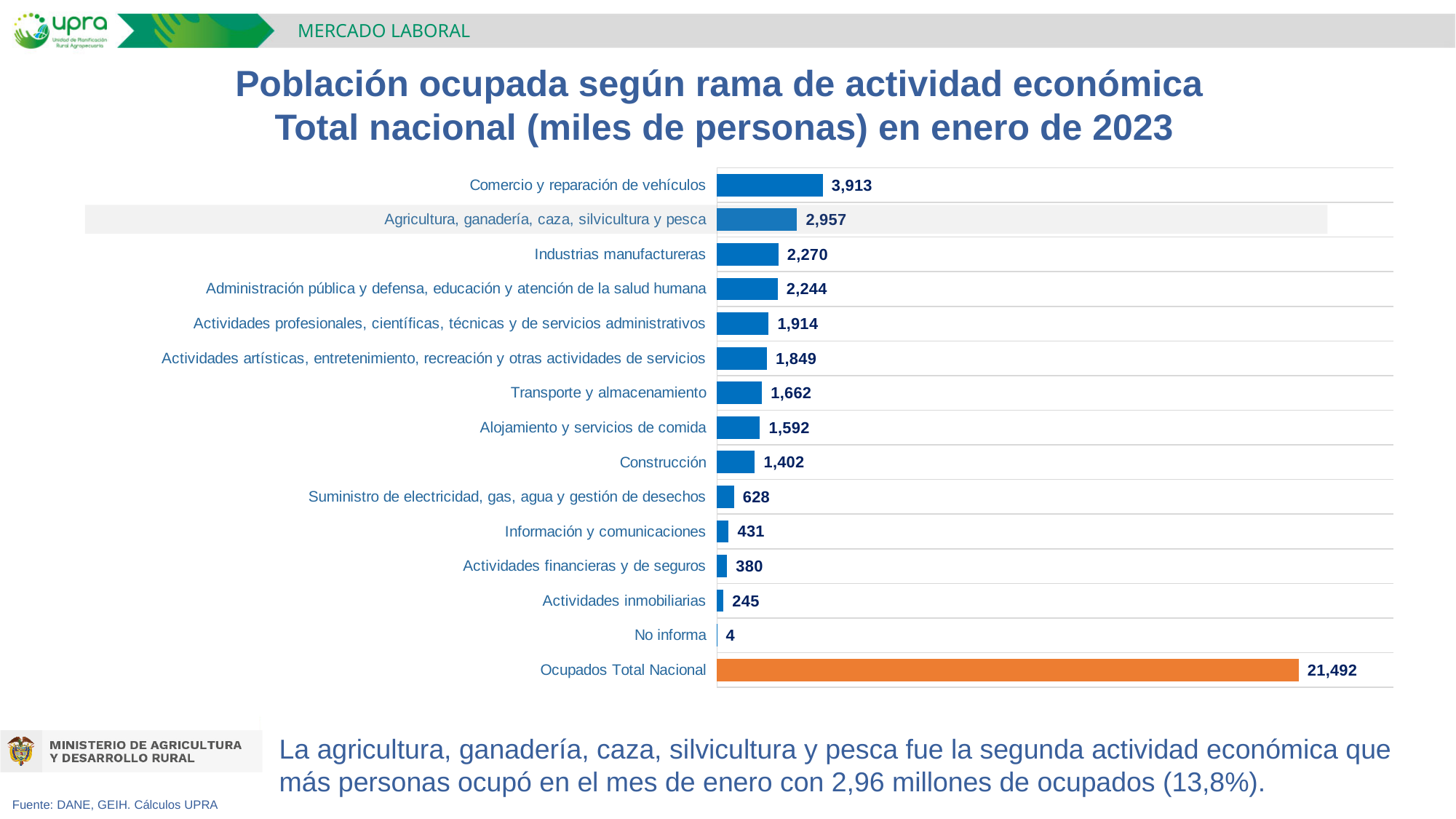
Which is larger, Industrias manufactureras or Actividades profesionales, científicas, técnicas y de servicios administrativos? Industrias manufactureras What is the difference between Comercio y reparación de vehículos and Agricultura, ganadería, caza, silvicultura y pesca? 956 What kind of chart is shown on the slide? Bar chart What is the value for Ocupados Total Nacional? 21,492 Which category has the lowest value? No informa Which economic activity (excluding the national total) has the highest value? Comercio y reparación de vehículos What is the value for Agricultura, ganadería, caza, silvicultura y pesca? 2,957 What is the difference between Transporte y almacenamiento and Alojamiento y servicios de comida? 70 What colour is the bar for Ocupados Total Nacional? Orange What is the value for Comercio y reparación de vehículos? 3,913 What is the value for Construcción? 1,402 How many bars are shown in the chart? 15